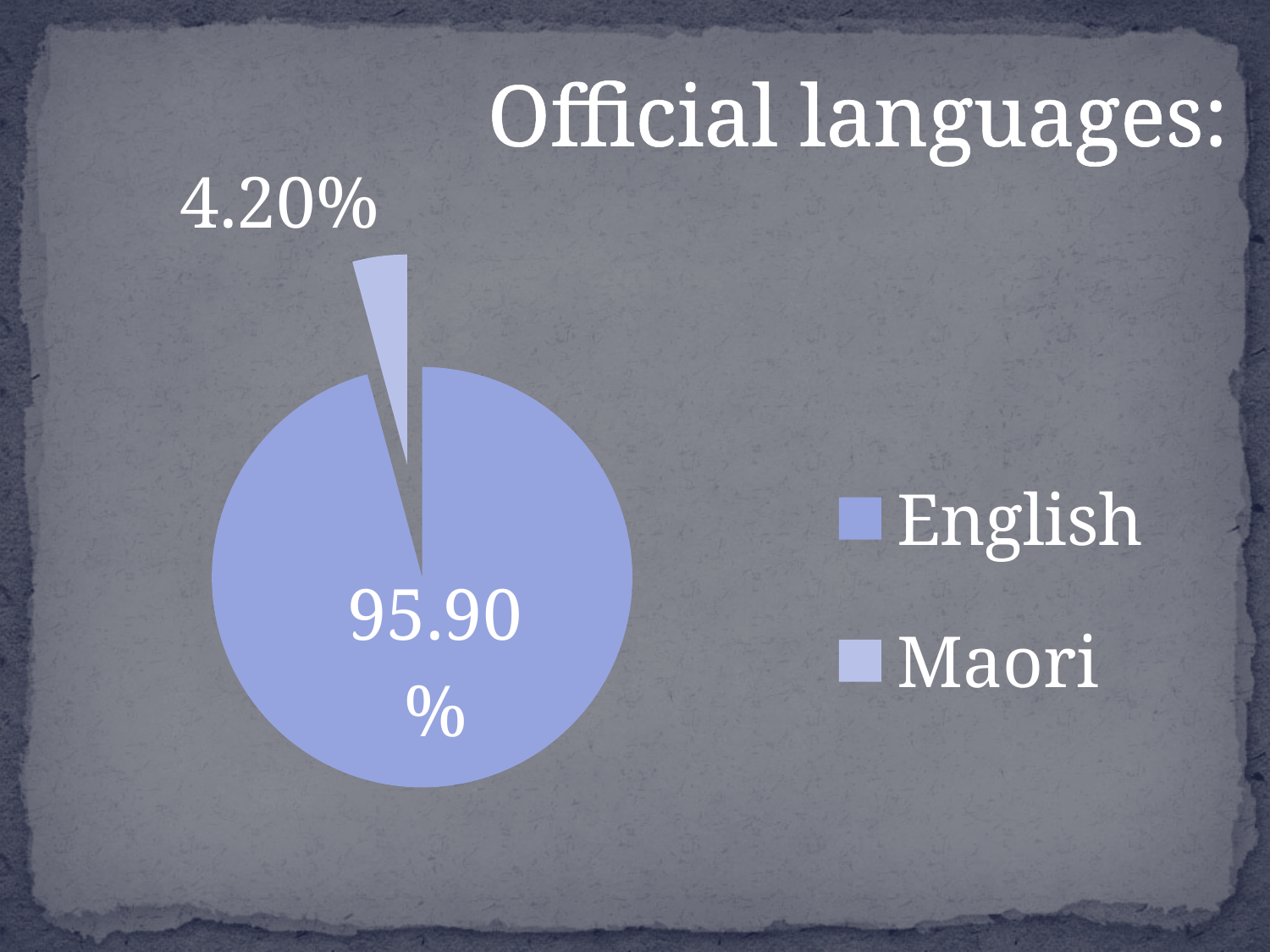
What percentage is shown for English? 95.90% What percentage is shown for Maori? 4.20% How many entries does the legend list? 2 What is the difference between the English and Maori percentages? 91.70% Which is larger, the share for English or the share for Maori? English Which language is shown in the lighter shade of blue? Maori Which language has the smallest slice of the pie? Maori What kind of chart is shown on the slide? pie chart How many slices does the pie chart have? 2 What is the title of the slide containing the chart? Official languages: Which language has the largest slice of the pie? English